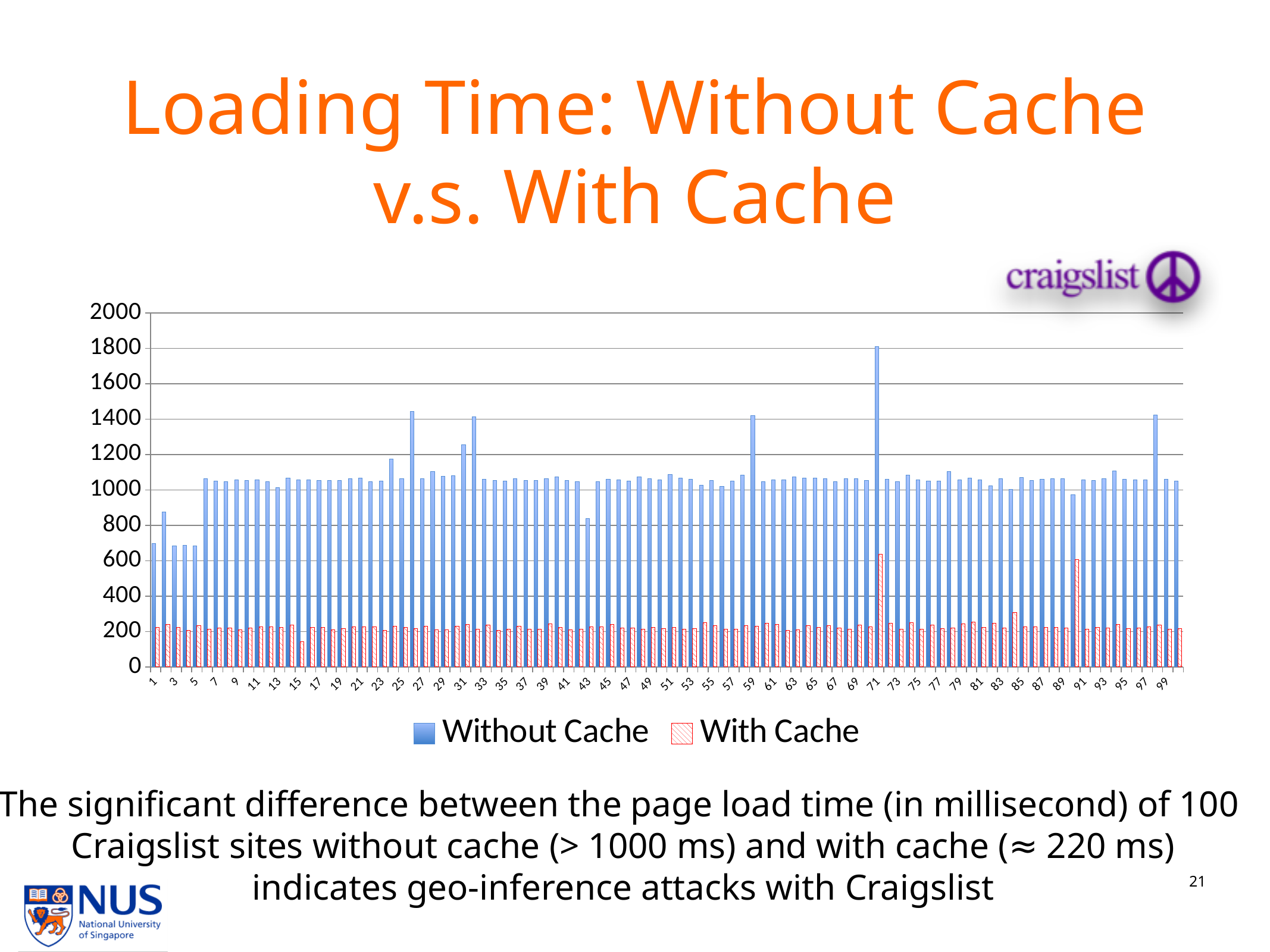
What is the title of the slide containing the chart? Loading Time: Without Cache v.s. With Cache How many series does the legend list? 2 Is the Without Cache value for site 43 greater or less than 1000? less Which site number has the highest Without Cache value? 71 For site 10, which is larger: the Without Cache value or the With Cache value? Without Cache What kind of chart is shown on the slide? bar chart What are the two series named in the legend? Without Cache, With Cache Is the Without Cache value for site 1 greater or less than 800? less Is the Without Cache value for site 71 greater or less than 1600? greater How many Craigslist sites are plotted along the x axis? 100